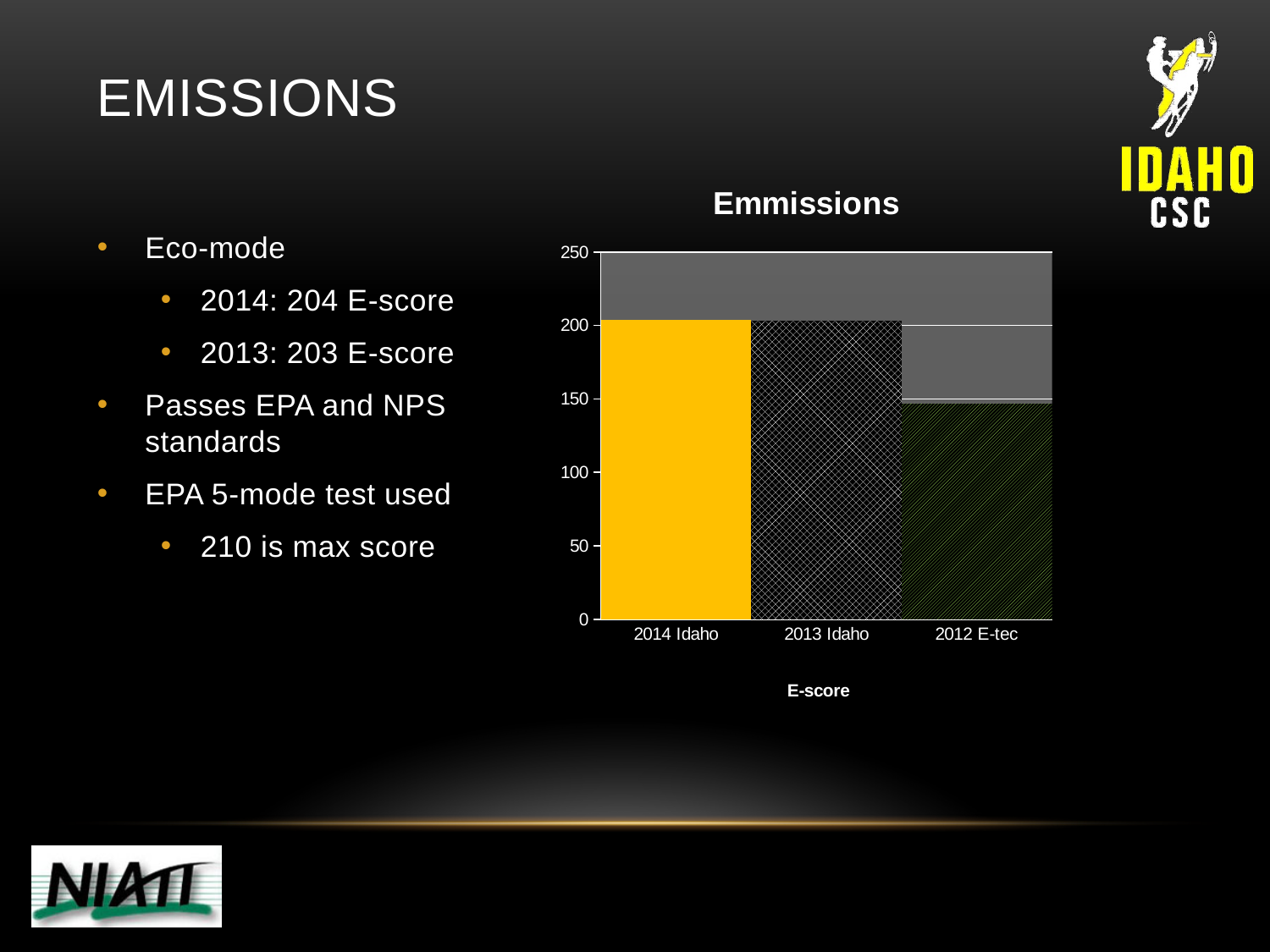
What is the label on the horizontal axis of the chart? E-score Is the value for 2014 Idaho greater or less than 150? greater What is the title of the chart? Emmissions How many categories are shown on the x axis of the chart? 3 Which category has the lowest value in the chart? 2012 E-tec Do the values rise or fall moving from 2014 Idaho to 2012 E-tec along the x axis? fall Is the value for 2012 E-tec greater or less than 200? less Which is larger, the value for 2014 Idaho or the value for 2012 E-tec? 2014 Idaho Is the value for 2013 Idaho greater or less than 250? less What kind of chart is shown on the slide? bar chart What is the E-score for 2014 Idaho, as stated on the slide? 204